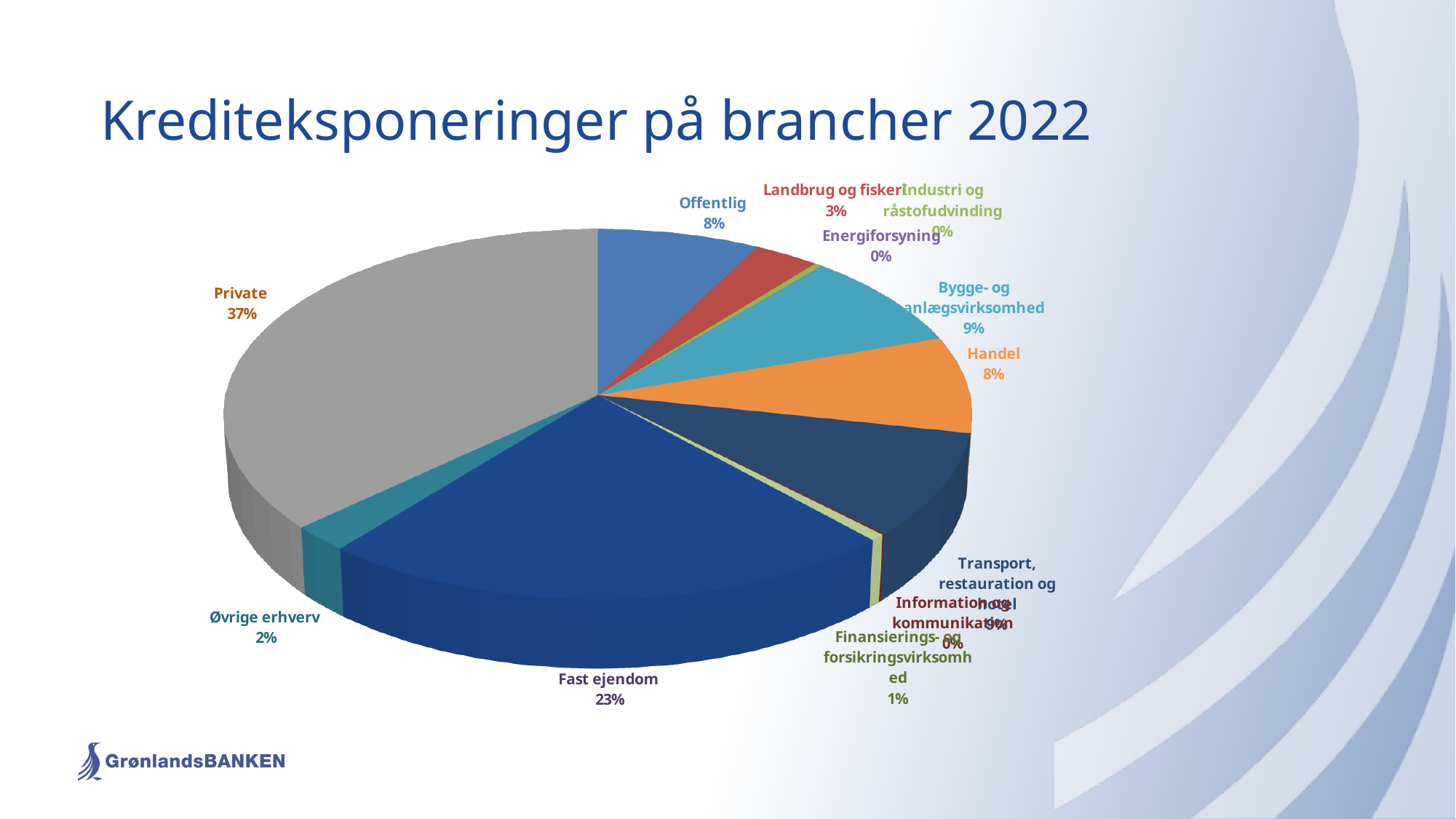
What is the value shown for Øvrige erhverv? 2% What share of the pie does Private account for? 37% What is the value shown for Bygge- og anlægsvirksomhed? 9% What is the value shown for Finansierings- og forsikringsvirksomhed? 1% Which category has the largest share of the pie? Private Which is larger, the share for Handel or the share for Bygge- og anlægsvirksomhed? Bygge- og anlægsvirksomhed What is the value shown for Landbrug og fiskeri? 3% What is the value shown for Offentlig? 8% What is the difference in percentage points between Private and Fast ejendom? 14 percentage points What is the title of the chart? Krediteksponeringer på brancher 2022 What share of the pie does Fast ejendom account for? 23% What kind of chart is shown on the slide? Pie chart